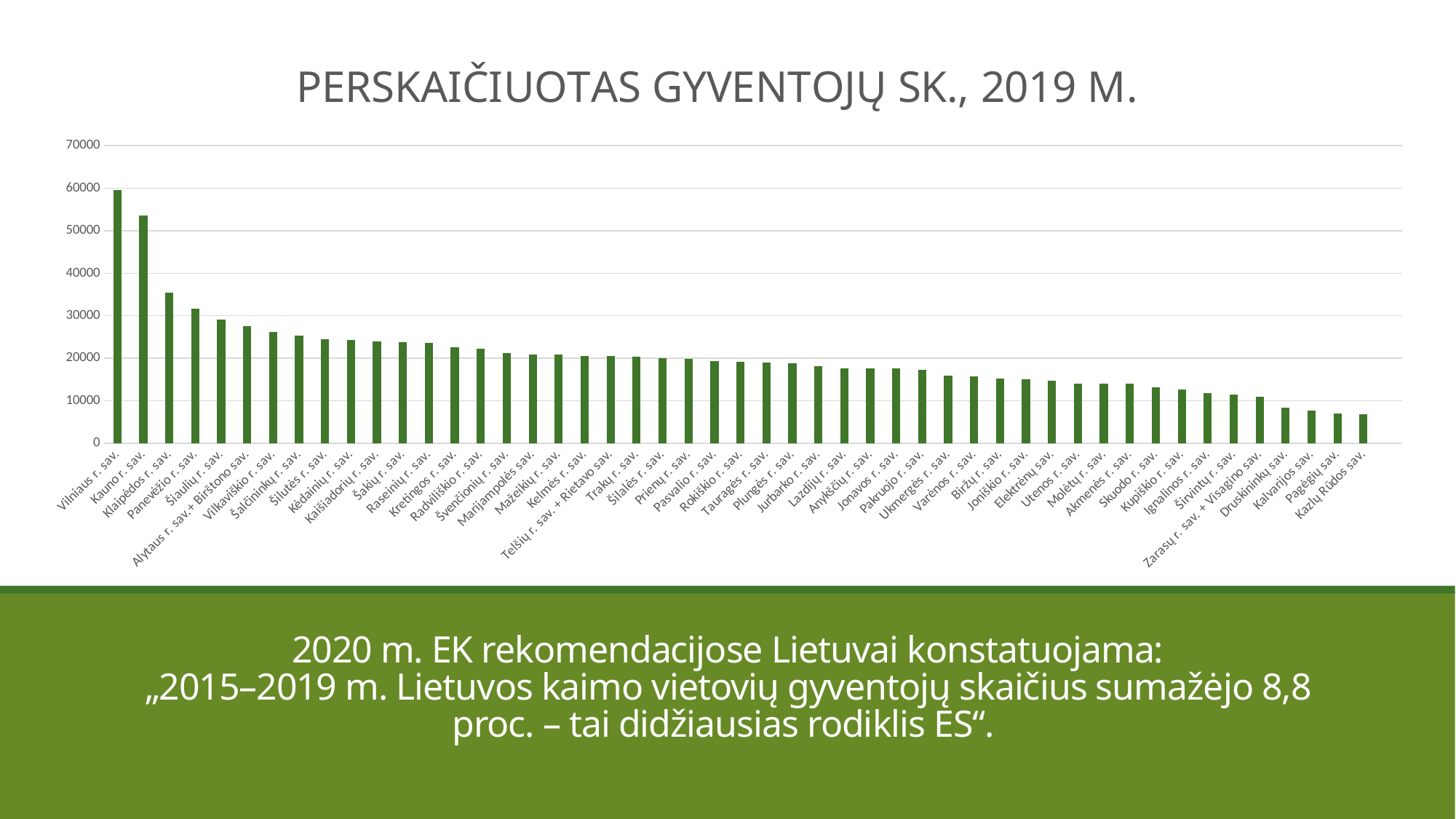
Which is larger, the value for Kauno r. sav. or the value for Klaipėdos r. sav.? Kauno r. sav. Which category has the highest value in the chart? Vilniaus r. sav. How many categories are plotted in the chart? 49 Which is larger, the value for Panevėžio r. sav. or the value for Utenos r. sav.? Panevėžio r. sav. Is the value for Druskininkų sav. greater or less than 10000? less Do the values rise or fall from left to right along the x axis? fall Is the value for Vilniaus r. sav. greater or less than 50000? greater Is the value for Klaipėdos r. sav. greater or less than 30000? greater What kind of chart is shown on the slide? bar chart What is the title of the chart? PERSKAIČIUOTAS GYVENTOJŲ SK., 2019 M.